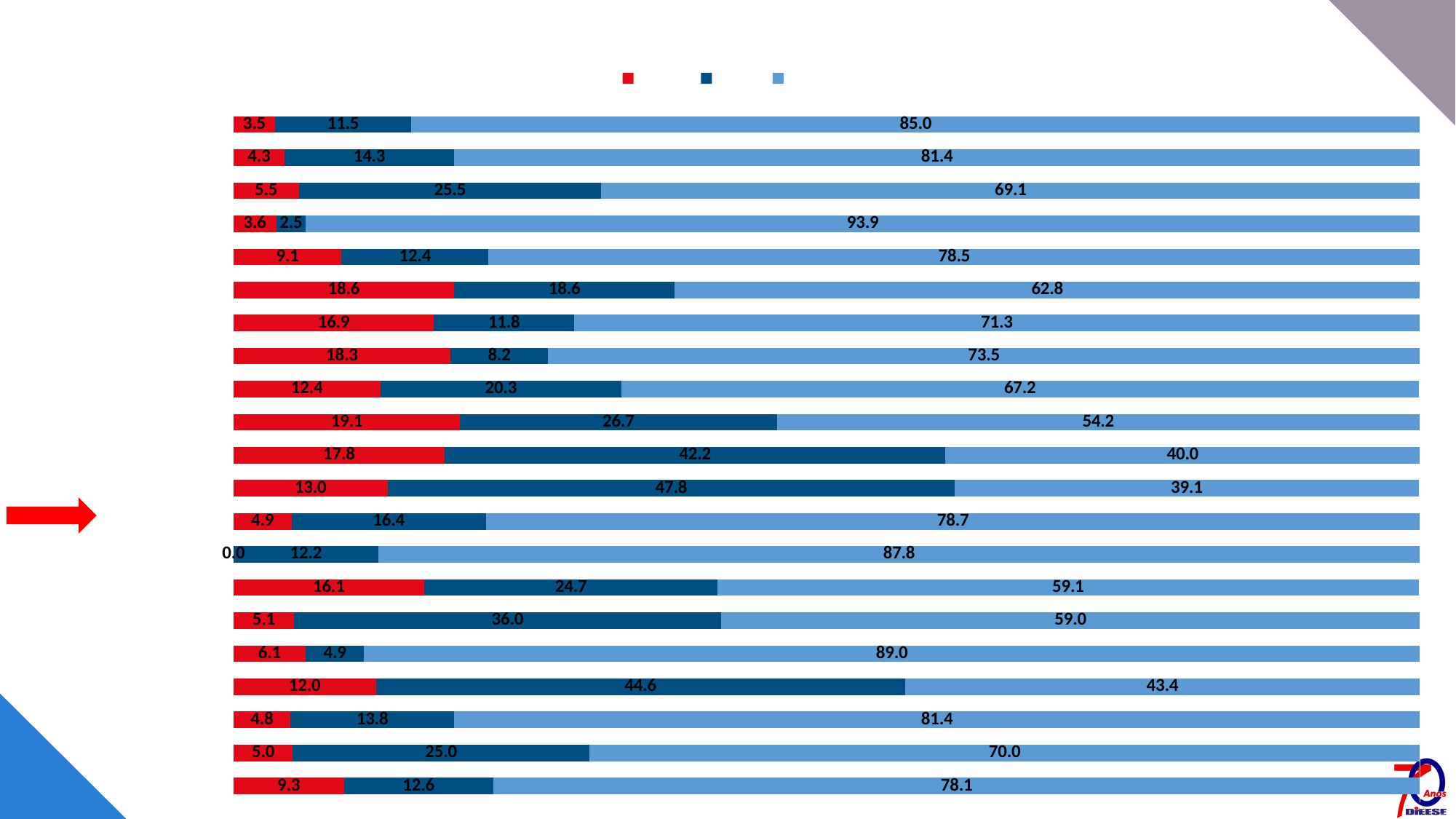
What is the largest light-blue segment value shown in the chart? 93.9 What is the value of the dark-blue segment in the bar marked by the red arrow? 16.4 What is the value of the red segment in the bar marked by the red arrow? 4.9 How many series does the legend show? 3 In the top bar, what is the difference between the light-blue segment and the dark-blue segment? 73.5 What kind of chart is shown on the slide? stacked bar chart What is the total of the three segments in the bar marked by the red arrow? 100.0 What is the value of the light-blue segment in the top bar of the chart? 85.0 What is the smallest light-blue segment value shown in the chart? 39.1 What is the value of the light-blue segment in the bottom bar of the chart? 78.1 How many bars are plotted in the chart? 21 In the bottom bar, which segment is larger, the red one or the dark-blue one? the dark-blue one